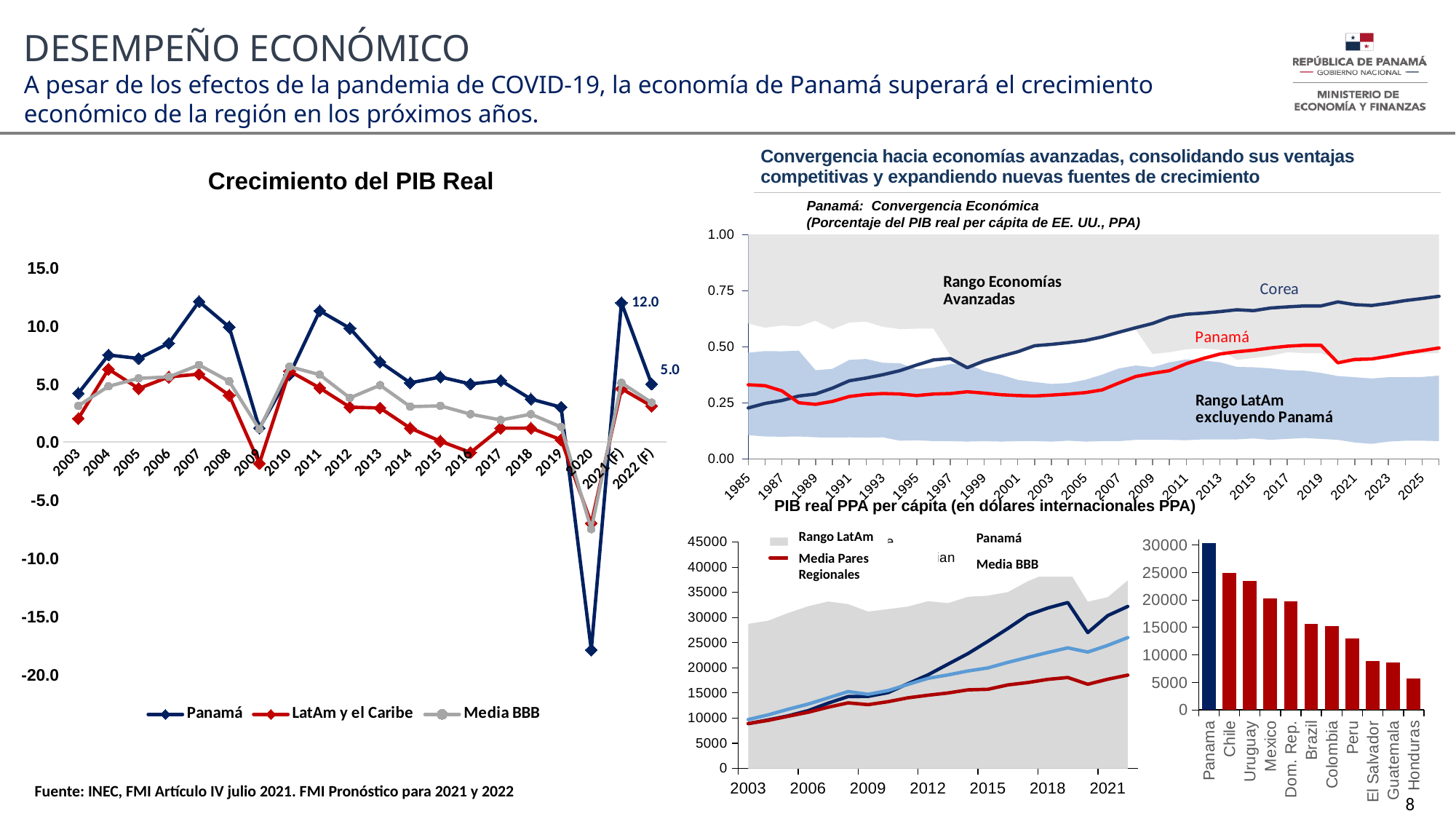
In the 'Crecimiento del PIB Real' chart, what is the value for Panamá in 2021 (F)? 12.0 In the 'Panamá: Convergencia Económica' chart, which line is higher in 2025, Corea or Panamá? Corea In the bar chart at the bottom right of the slide, which country has the highest bar? Panama In the 'Crecimiento del PIB Real' chart, what is the value for Panamá in 2022 (F)? 5.0 In the 'Crecimiento del PIB Real' chart, in which year is the Panamá value lowest? 2020 In the bar chart at the bottom right of the slide, which country has the lowest bar? Honduras What kind of chart is the 'Crecimiento del PIB Real' chart? line chart In the bar chart at the bottom right of the slide, is the value for Panama greater or less than 25000? greater How many countries are shown in the bar chart at the bottom right of the slide? 11 In the 'Crecimiento del PIB Real' chart, is the Panamá value for 2020 greater or less than -15.0? less How many series does the legend of the 'Crecimiento del PIB Real' chart list? 3 In the 'Crecimiento del PIB Real' chart, what is the difference between the Panamá values for 2021 (F) and 2022 (F)? 7.0